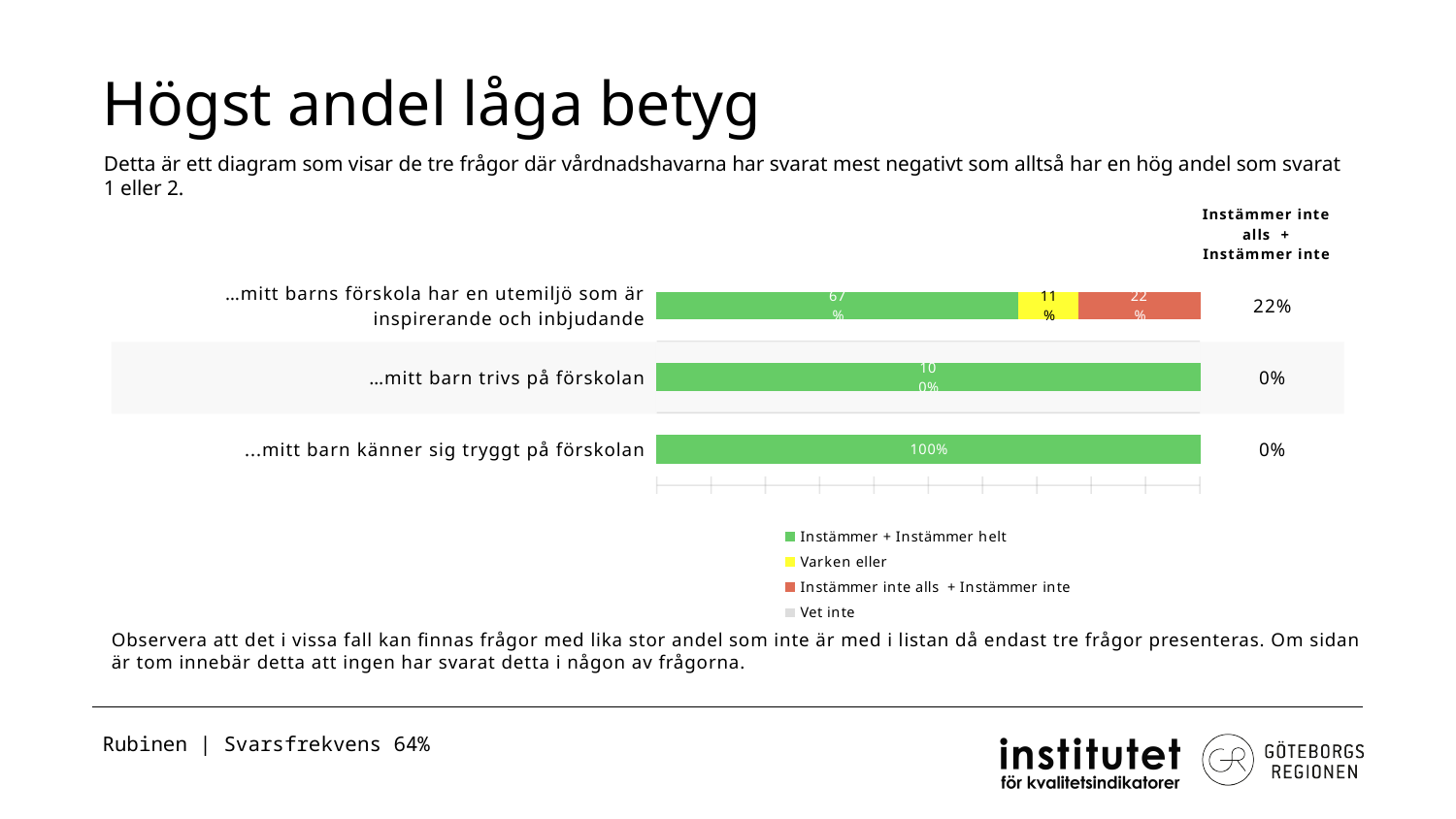
What is the difference between the 'Instämmer + Instämmer helt' share and the 'Instämmer inte alls + Instämmer inte' share for '…mitt barns förskola har en utemiljö som är inspirerande och inbjudande'? 45% How many series does the legend list? 4 Which colour represents 'Varken eller' in the legend? Yellow What is the 'Instämmer inte alls + Instämmer inte' share for '…mitt barns förskola har en utemiljö som är inspirerande och inbjudande'? 22% What is the 'Instämmer + Instämmer helt' share for '…mitt barn känner sig tryggt på förskolan'? 100% What kind of chart is shown on the slide? Stacked bar chart How many questions (categories) are plotted in the chart? 3 Which question has the highest share of 'Instämmer inte alls + Instämmer inte' responses? …mitt barns förskola har en utemiljö som är inspirerande och inbjudande Which is larger for '…mitt barns förskola har en utemiljö som är inspirerande och inbjudande': the 'Varken eller' share or the 'Instämmer inte alls + Instämmer inte' share? Instämmer inte alls + Instämmer inte What is the 'Instämmer + Instämmer helt' share for '…mitt barns förskola har en utemiljö som är inspirerande och inbjudande'? 67% What value is shown in the right-hand 'Instämmer inte alls + Instämmer inte' column for '…mitt barn trivs på förskolan'? 0% What is the 'Varken eller' share for '…mitt barns förskola har en utemiljö som är inspirerande och inbjudande'? 11%